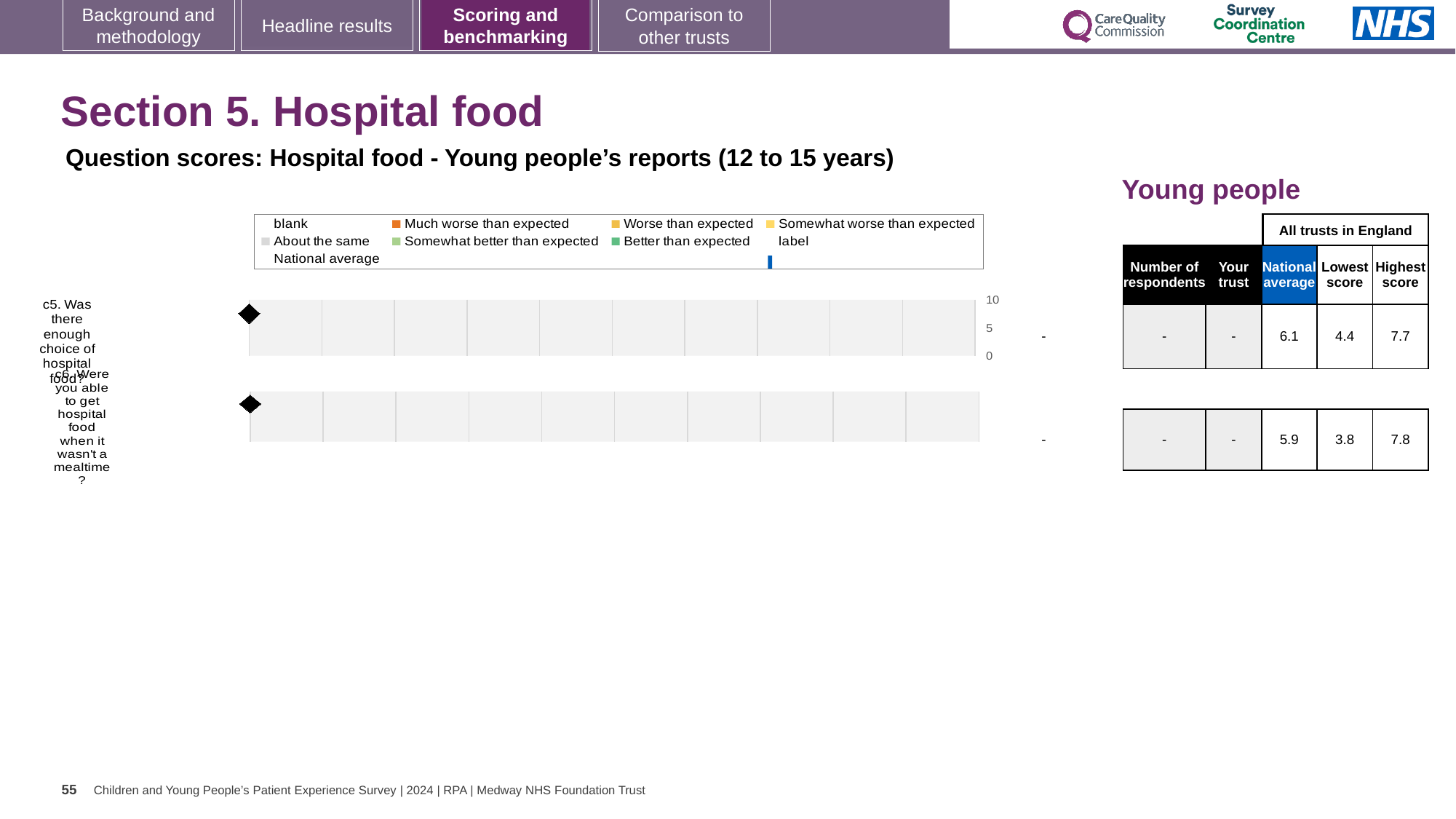
What is the difference between the highest score and the lowest score for c5 in the table? 3.3 What is the highest value shown on the chart's score axis? 10 In the table, what is the national average score for c6 (Were you able to get hospital food when it wasn't a mealtime?)? 5.9 In the table, what is the lowest score across all trusts in England for c5? 4.4 What is the difference between the highest score and the lowest score for c6 in the table? 4.0 Is the national average score for c6 greater or less than 5? greater How many questions (categories) are plotted on the chart? 2 In the table, what is the highest score across all trusts in England for c6? 7.8 In the table, what is the national average score for c5 (Was there enough choice of hospital food?)? 6.1 What kind of chart is shown on the slide? bar chart Which legend entry is shown with an orange marker? Much worse than expected Which question has the higher national average score, c5 or c6? c5